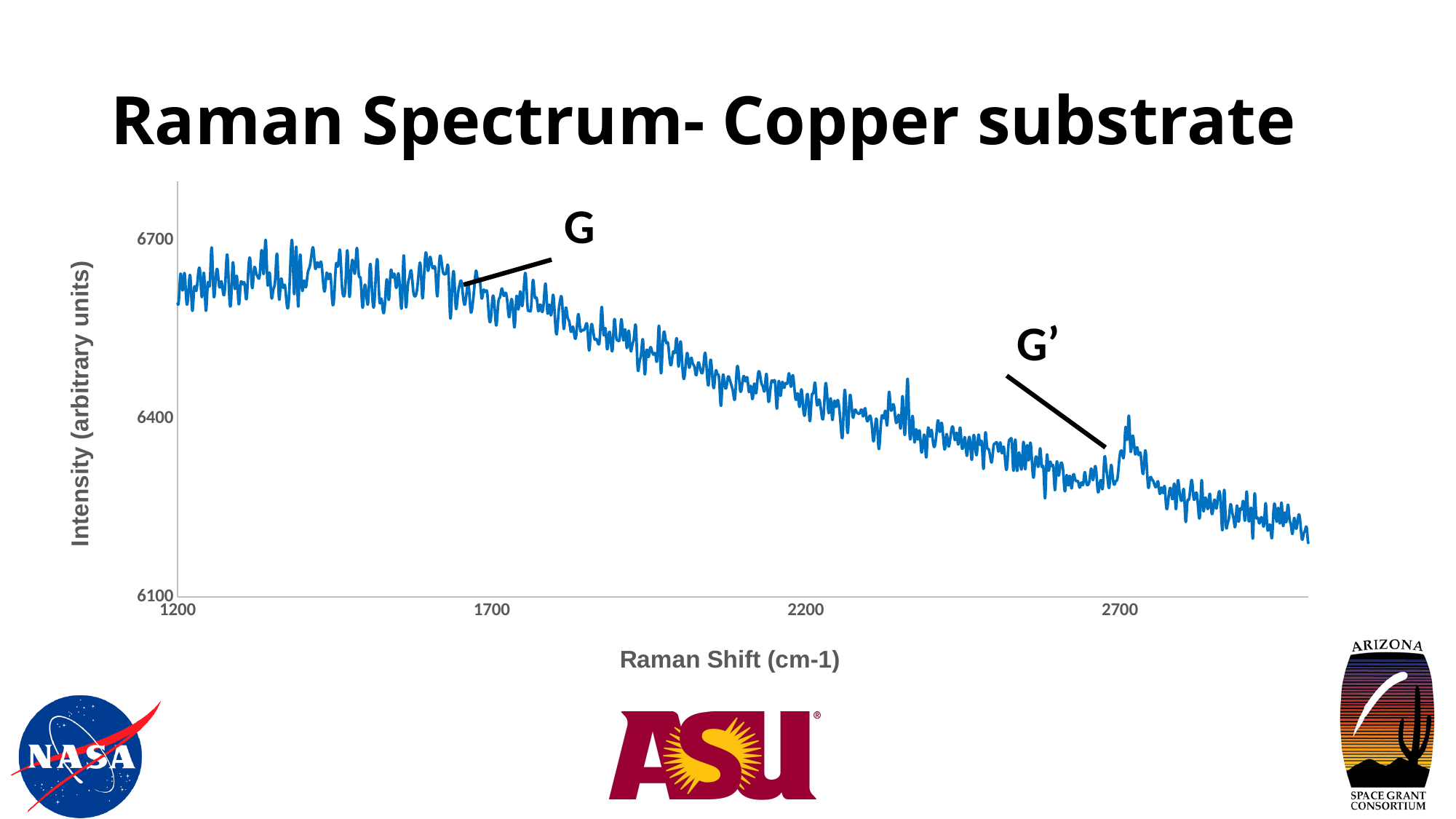
What is the title of the chart? Raman Spectrum- Copper substrate How many data series (lines) are plotted on the chart? 1 What kind of chart is shown on the slide? line chart Is the intensity at a Raman shift of 2700 greater or less than 6400? less Is the intensity at a Raman shift of 2200 greater or less than 6700? less Is the intensity at a Raman shift of 1200 greater or less than 6400? greater What is the label of the x axis? Raman Shift (cm-1) Which has the lower intensity: the spectrum at a Raman shift of 1700 or at 2200? 2200 Which has the higher intensity: the spectrum at a Raman shift of 1200 or at 2700? 1200 Does the intensity generally rise or fall as the Raman shift increases from 1200 to 3000? fall